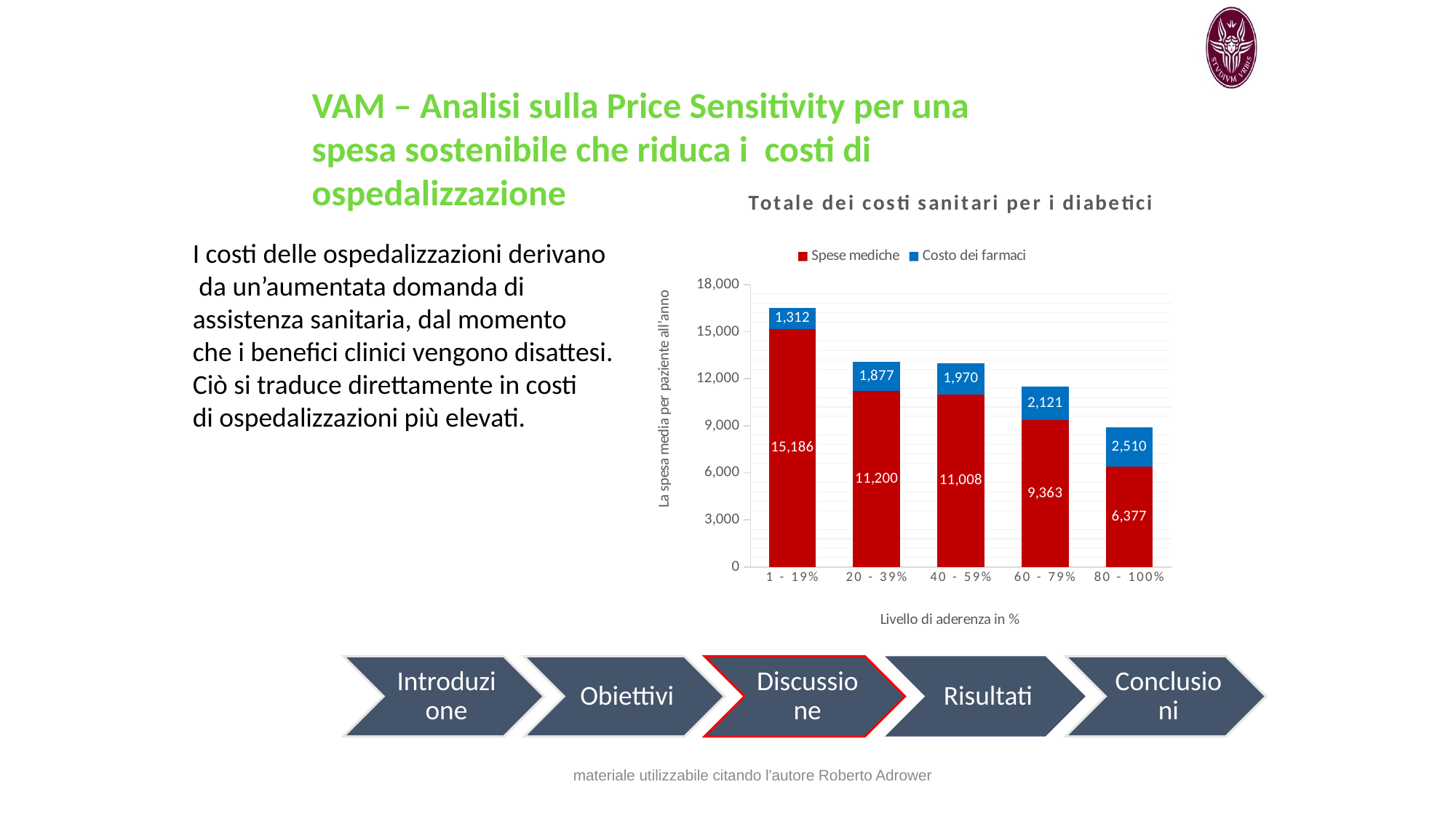
What is the title of the chart? Totale dei costi sanitari per i diabetici What type of chart is shown on the slide? Stacked bar chart What is the value of Costo dei farmaci for the 80 - 100% adherence level? 2,510 Which is larger: Costo dei farmaci for 60 - 79% or for 40 - 59%? 60 - 79% What is the total of the stacked bar for the 80 - 100% adherence level? 8,887 Which adherence level has the lowest Costo dei farmaci value? 1 - 19% How many series does the chart legend list? 2 How many adherence-level categories are shown on the x axis? 5 What is the value of Spese mediche for the 1 - 19% adherence level? 15,186 What is the difference between Spese mediche for 20 - 39% and for 40 - 59%? 192 Do the Spese mediche values rise or fall as the adherence level increases along the x axis? Fall Which adherence level has the highest Spese mediche value? 1 - 19%